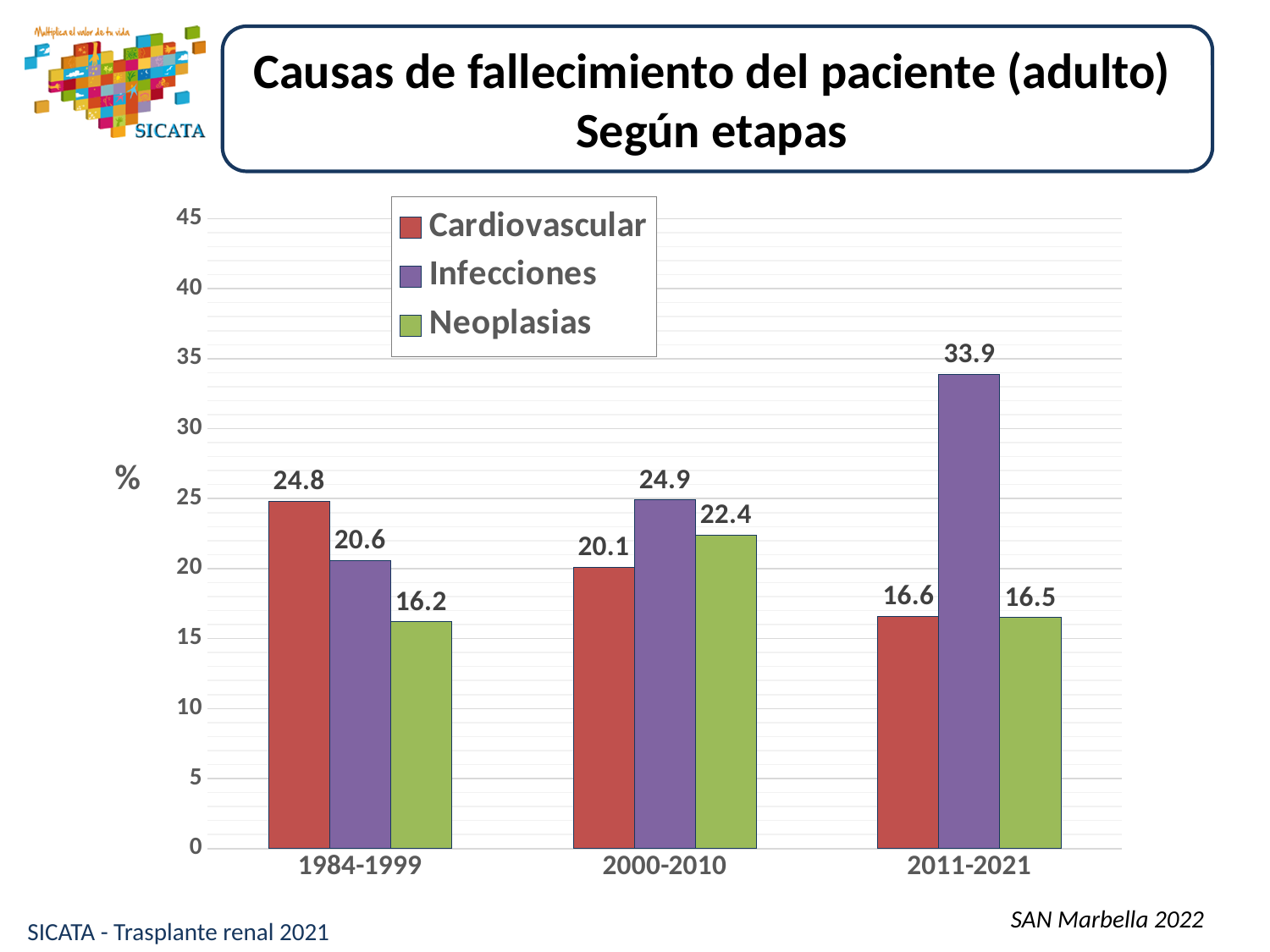
What is the Cardiovascular value for 1984-1999? 24.8 What is the difference between the Infecciones value and the Cardiovascular value in 2011-2021? 17.3 Is the Infecciones value for 2011-2021 greater or less than 30? greater How many periods are shown on the x axis? 3 In which period is the Cardiovascular value lowest? 2011-2021 In which period is the Infecciones value highest? 2011-2021 How many series does the legend list? 3 What is the Infecciones value for 2011-2021? 33.9 What kind of chart is shown? Bar chart What is the Neoplasias value for 2000-2010? 22.4 Which is larger in 1984-1999, Cardiovascular or Neoplasias? Cardiovascular Does the Cardiovascular value rise or fall across the periods from 1984-1999 to 2011-2021? Fall